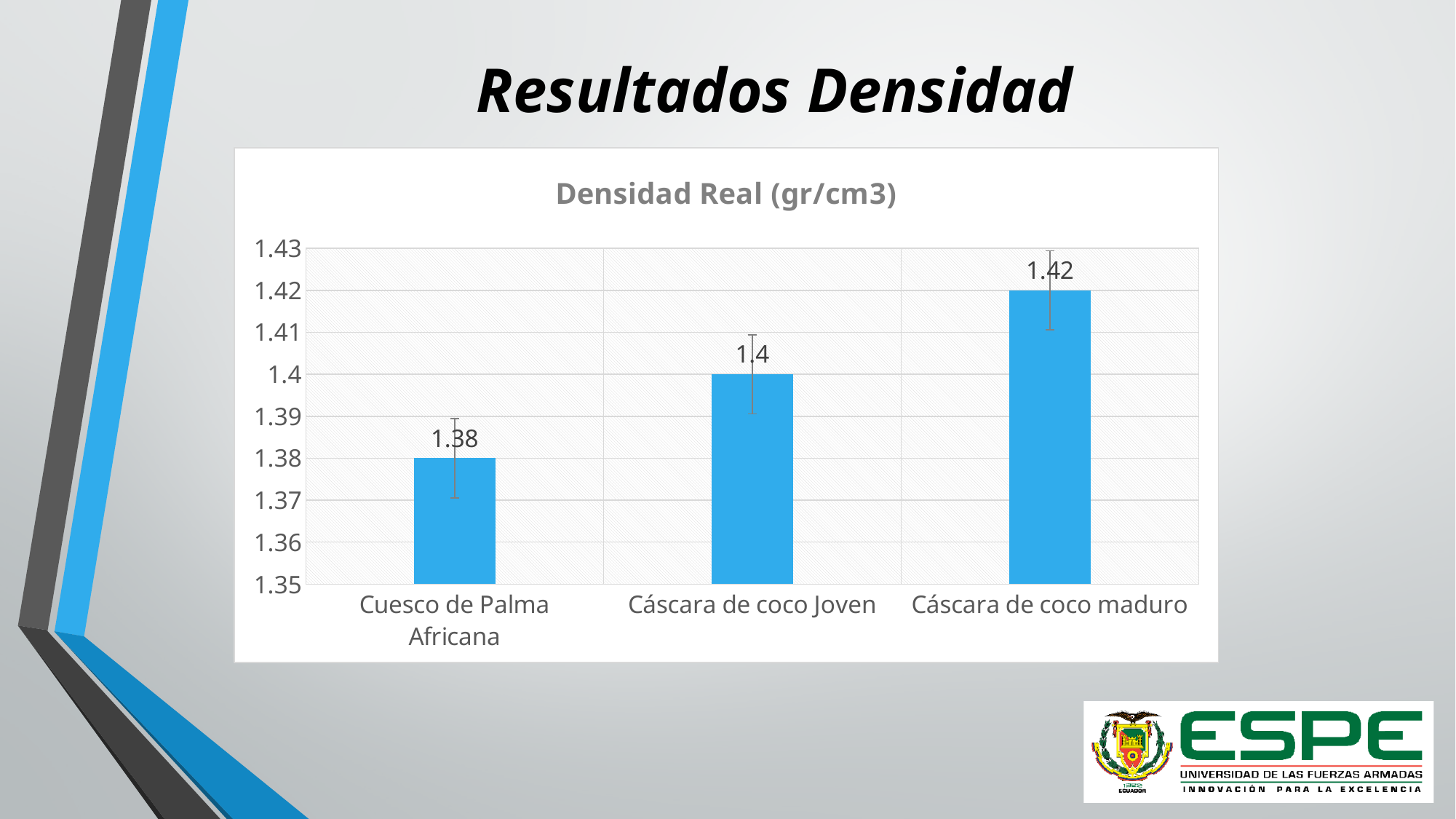
Which category has the highest Densidad Real? Cáscara de coco maduro What is the title of the chart? Densidad Real (gr/cm3) What is the difference in Densidad Real between Cáscara de coco maduro and Cuesco de Palma Africana? 0.04 What is the Densidad Real value for Cuesco de Palma Africana? 1.38 How many categories are shown in the chart? 3 What is the Densidad Real value for Cáscara de coco maduro? 1.42 What is the Densidad Real value for Cáscara de coco Joven? 1.4 Which has a larger Densidad Real, Cáscara de coco Joven or Cáscara de coco maduro? Cáscara de coco maduro Is the value for Cuesco de Palma Africana greater or less than 1.4? less Which category has the lowest Densidad Real? Cuesco de Palma Africana What is the difference in Densidad Real between Cáscara de coco Joven and Cuesco de Palma Africana? 0.02 What kind of chart is shown on the slide? bar chart